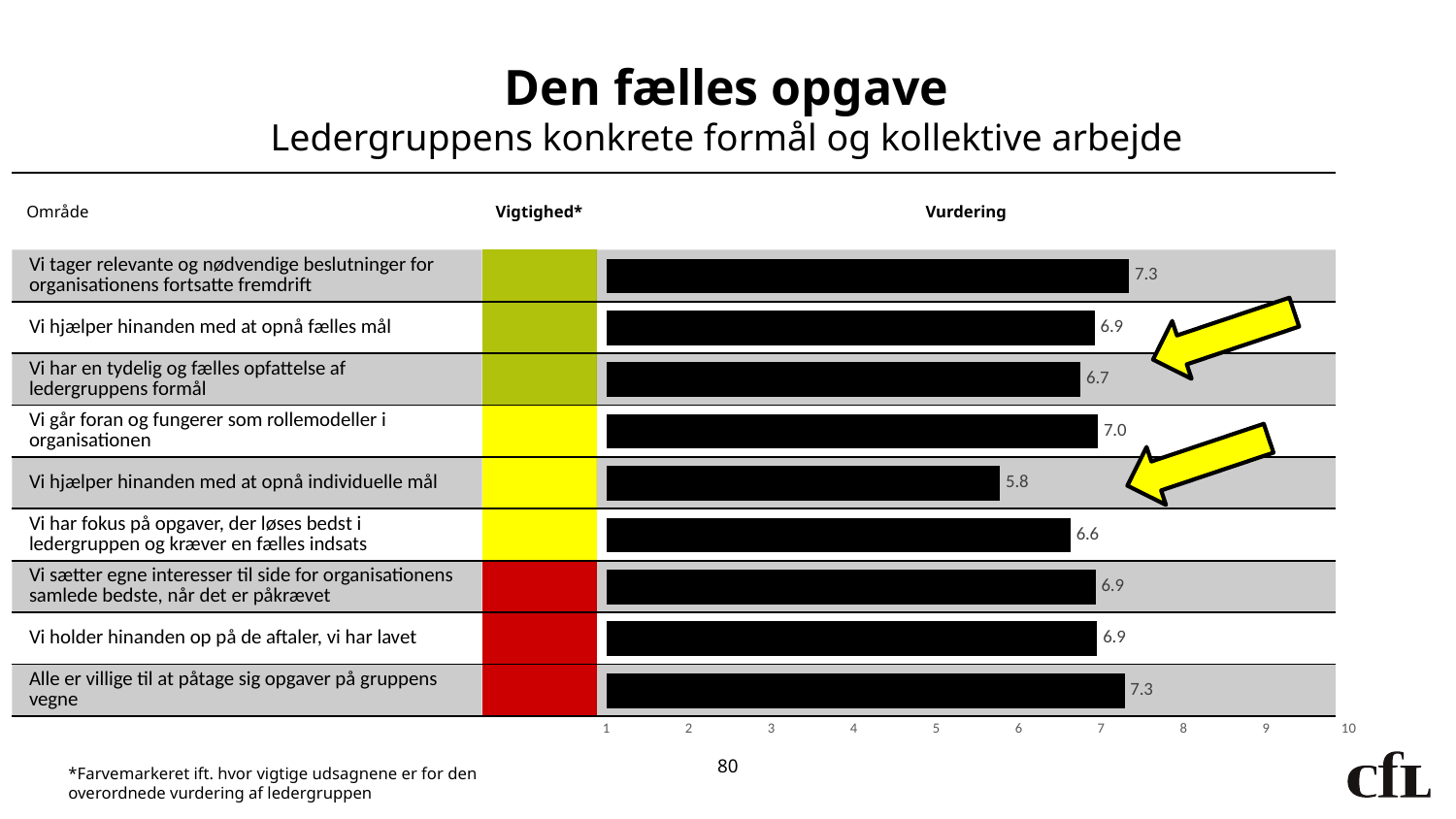
What is the difference between the Vurdering values for "Vi tager relevante og nødvendige beslutninger for organisationens fortsatte fremdrift" and "Vi hjælper hinanden med at opnå individuelle mål"? 1.5 What kind of chart is shown on the slide? bar chart What is the Vurdering value for "Vi hjælper hinanden med at opnå individuelle mål"? 5.8 Is the Vurdering value for "Vi hjælper hinanden med at opnå individuelle mål" greater or less than 6? less What is the highest value shown on the horizontal axis of the chart? 10 Which has a higher Vurdering value: "Vi går foran og fungerer som rollemodeller i organisationen" or "Vi har fokus på opgaver, der løses bedst i ledergruppen og kræver en fælles indsats"? Vi går foran og fungerer som rollemodeller i organisationen What is the Vurdering value for "Vi går foran og fungerer som rollemodeller i organisationen"? 7.0 Which statement has the lowest Vurdering value? Vi hjælper hinanden med at opnå individuelle mål How many statements (bars) are plotted in the chart? 9 What is the Vurdering value for "Vi har fokus på opgaver, der løses bedst i ledergruppen og kræver en fælles indsats"? 6.6 What is the Vurdering value for "Alle er villige til at påtage sig opgaver på gruppens vegne"? 7.3 What is the Vurdering value for "Vi har en tydelig og fælles opfattelse af ledergruppens formål"? 6.7